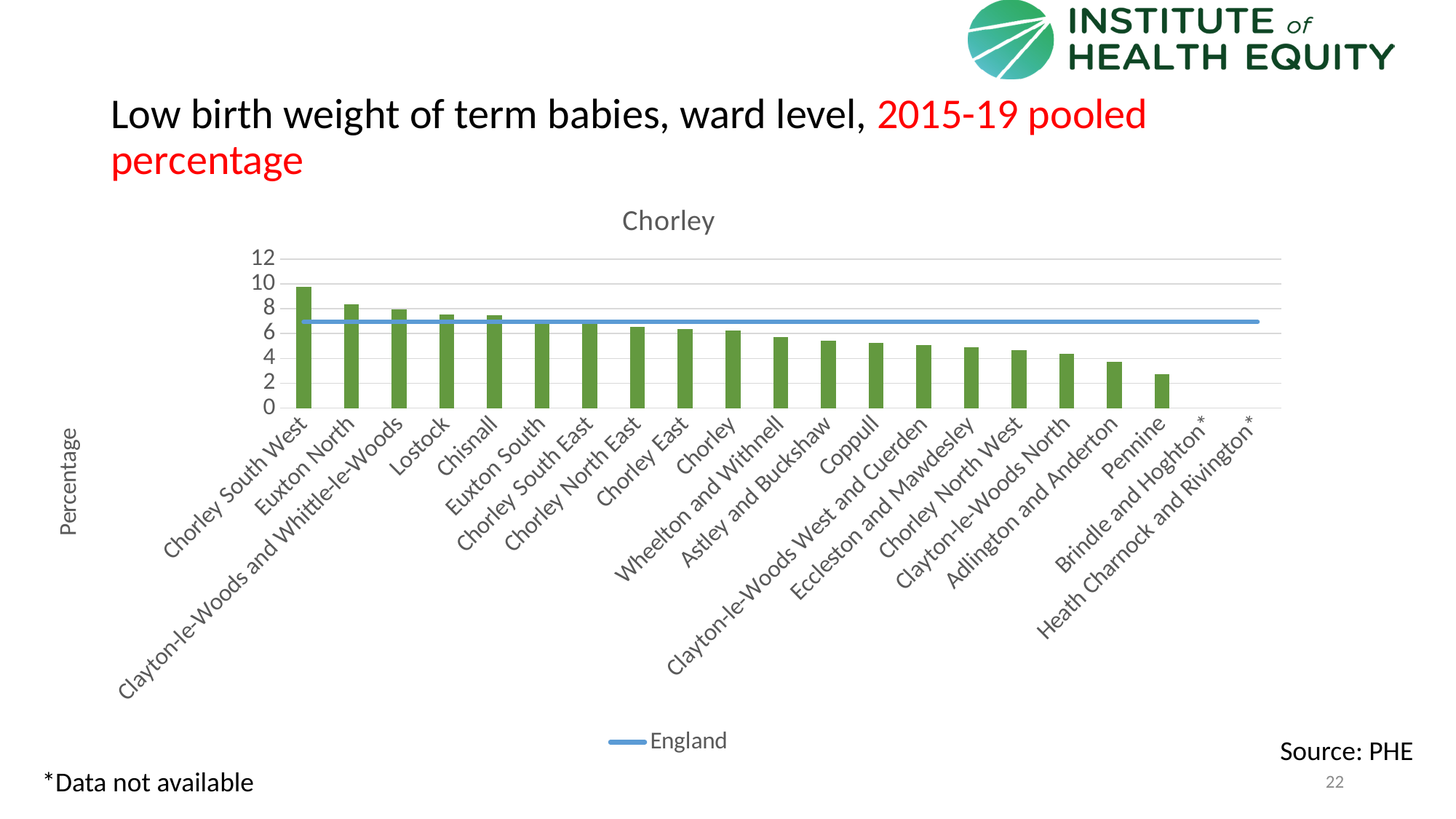
Is the value for Chorley South West greater or less than 8? greater Which two wards are marked with an asterisk as having no data available? Brindle and Hoghton; Heath Charnock and Rivington How many ward categories are labelled on the x axis? 21 Which ward has the highest low birth weight percentage in the chart? Chorley South West Is the value for Pennine greater or less than 4? less Do the bar values rise or fall moving from left to right along the x axis? Fall What kind of chart is shown on the slide? Combination bar and line chart Is the value for Coppull greater or less than 6? less Among the wards with a plotted bar, which has the lowest low birth weight percentage? Pennine What series does the legend list? England Which is larger, the value for Lostock or the value for Adlington and Anderton? Lostock